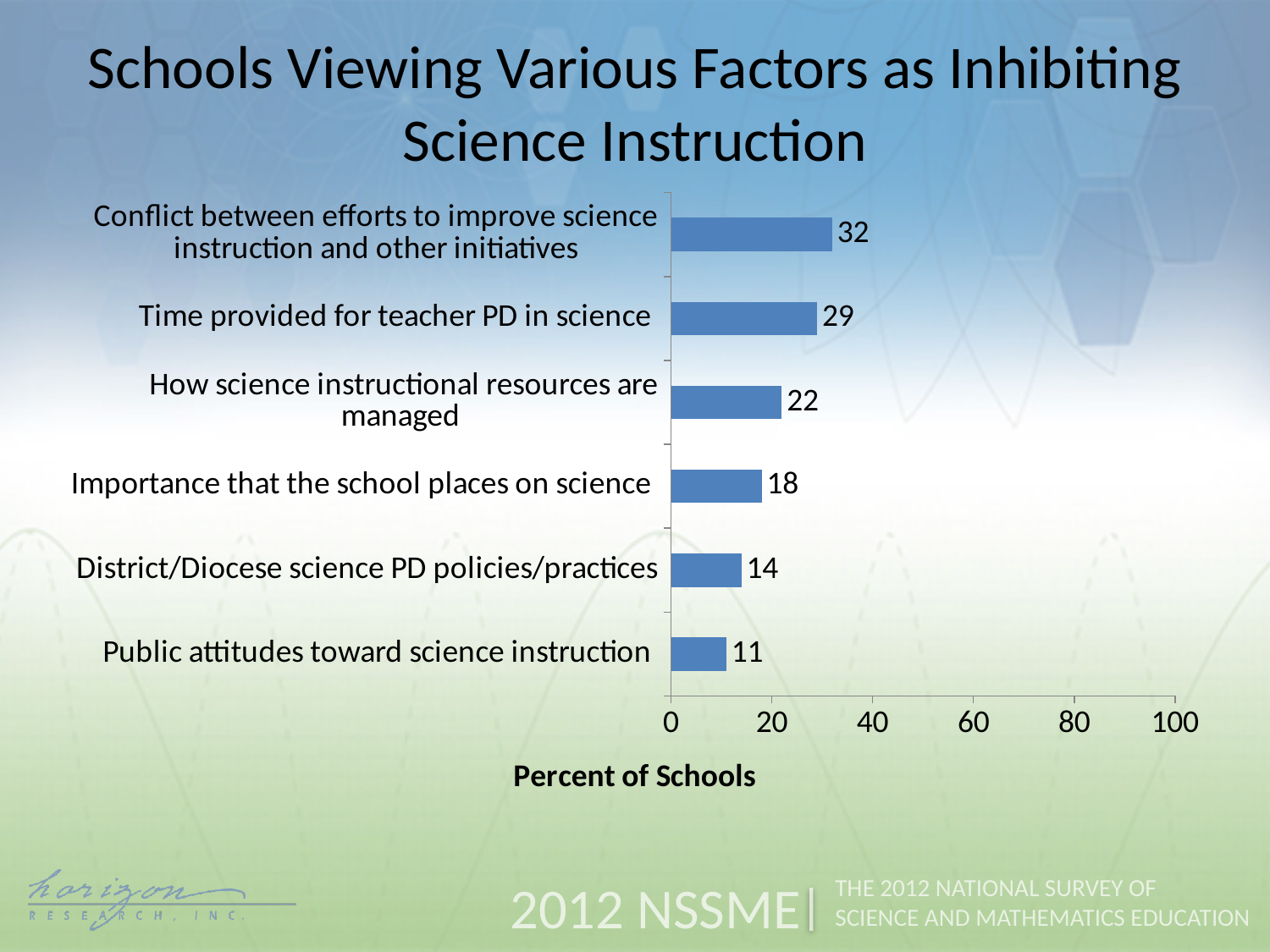
Which is larger: the value for 'Importance that the school places on science' or 'District/Diocese science PD policies/practices'? Importance that the school places on science What kind of chart is shown on the slide? Bar chart What is the value for 'How science instructional resources are managed'? 22 What is the difference between the values for 'Time provided for teacher PD in science' and 'How science instructional resources are managed'? 7 What is the value for 'Public attitudes toward science instruction'? 11 Which factor has the highest percent of schools? Conflict between efforts to improve science instruction and other initiatives Is the value for 'Time provided for teacher PD in science' greater or less than 40? less How many factors are shown in the chart? 6 What is the label of the horizontal axis? Percent of Schools Which factor has the lowest percent of schools? Public attitudes toward science instruction What is the difference between the values for 'Conflict between efforts to improve science instruction and other initiatives' and 'Public attitudes toward science instruction'? 21 What percent of schools view 'Time provided for teacher PD in science' as inhibiting science instruction? 29